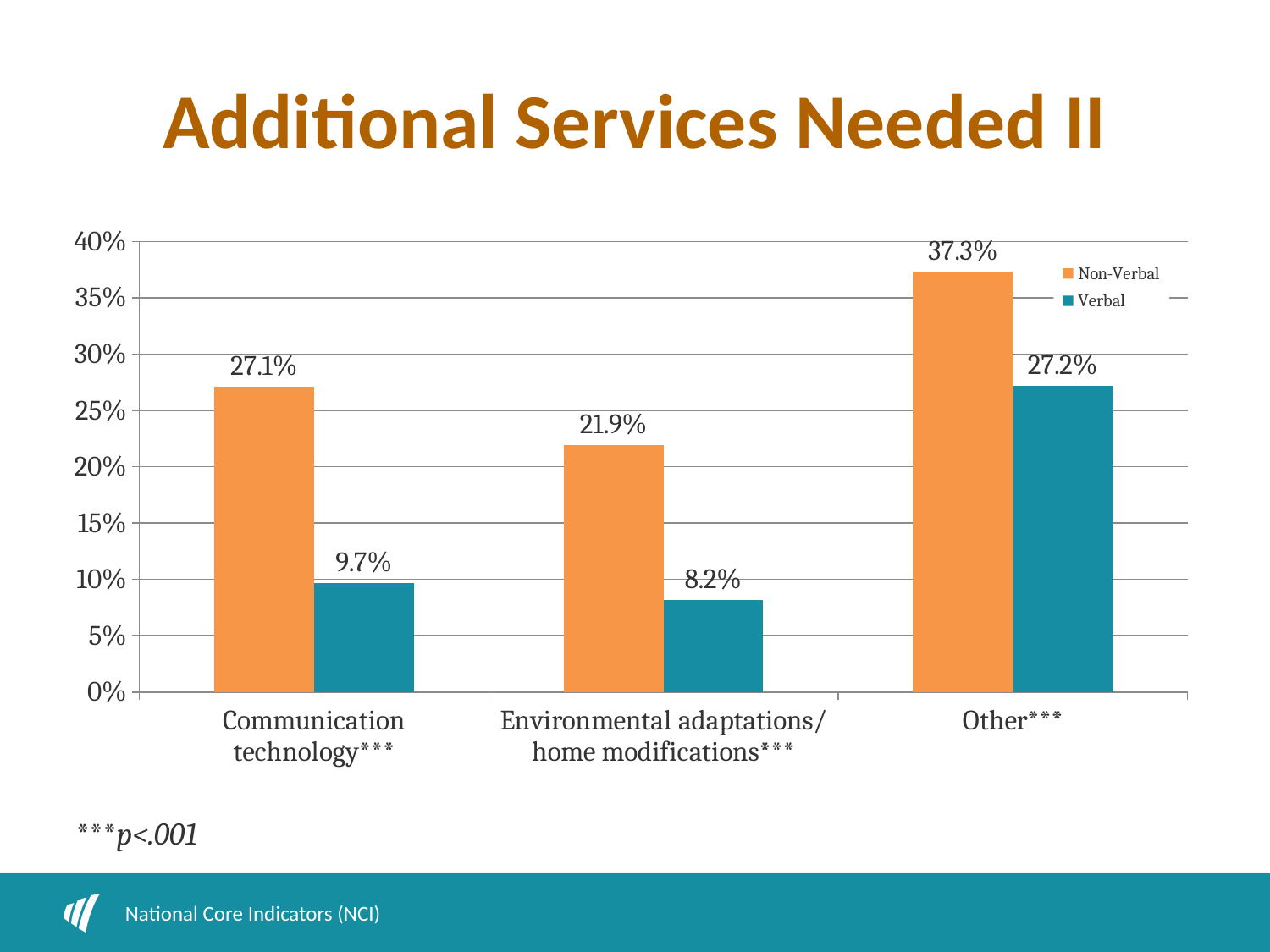
Which is larger for Other: the Non-Verbal value or the Verbal value? Non-Verbal Which category has the highest Non-Verbal value? Other*** What kind of chart is shown on the slide? Bar chart What is the difference between the Non-Verbal and Verbal values for Communication technology? 17.4% How many categories are shown on the x axis? 3 Which category has the lowest Verbal value? Environmental adaptations/home modifications*** What is the Non-Verbal value for Other? 37.3% What is the Verbal value for Communication technology? 9.7% How many series does the legend list? 2 What is the Non-Verbal value for Communication technology? 27.1% What is the title of the slide? Additional Services Needed II What is the Verbal value for Environmental adaptations/home modifications? 8.2%